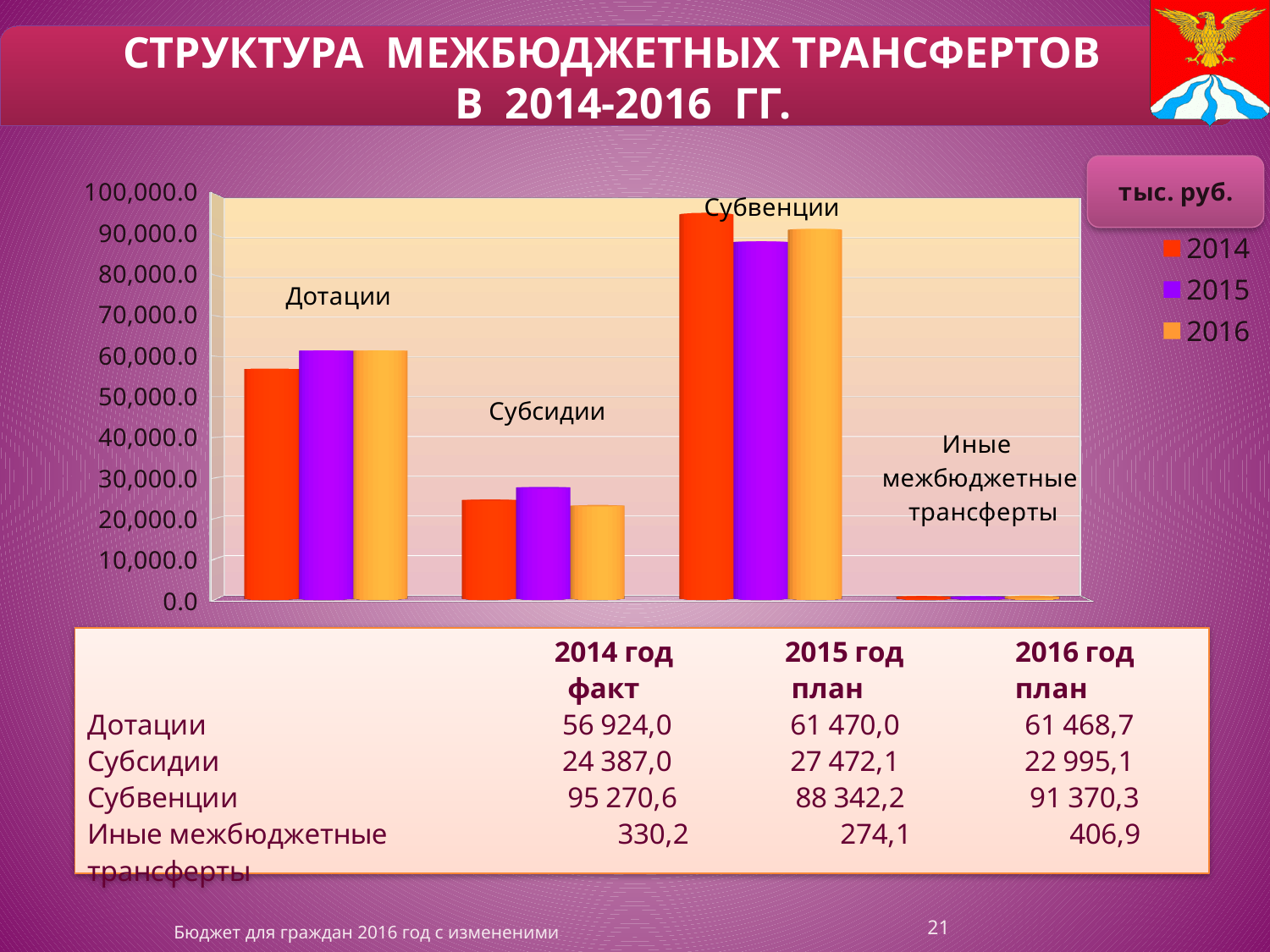
Which category has the highest value in 2014? Субвенции What kind of chart is shown on the slide? bar chart What is the value for Иные межбюджетные трансферты in 2015 (тыс. руб.)? 274,1 Which category has the lowest value in 2016? Иные межбюджетные трансферты What is the difference between the 2014 and 2015 values for Дотации (тыс. руб.)? 4 546,0 How many series does the chart legend list? 3 Which is larger for Субсидии: the 2015 value or the 2016 value? 2015 What is the value for Субвенции in 2016 (тыс. руб.)? 91 370,3 What is the value for Дотации in 2014 (тыс. руб.)? 56 924,0 Is the value for Субвенции in 2015 greater or less than 80,000.0? greater Which colour represents the 2015 series in the chart? purple How many categories are shown on the chart's x axis? 4